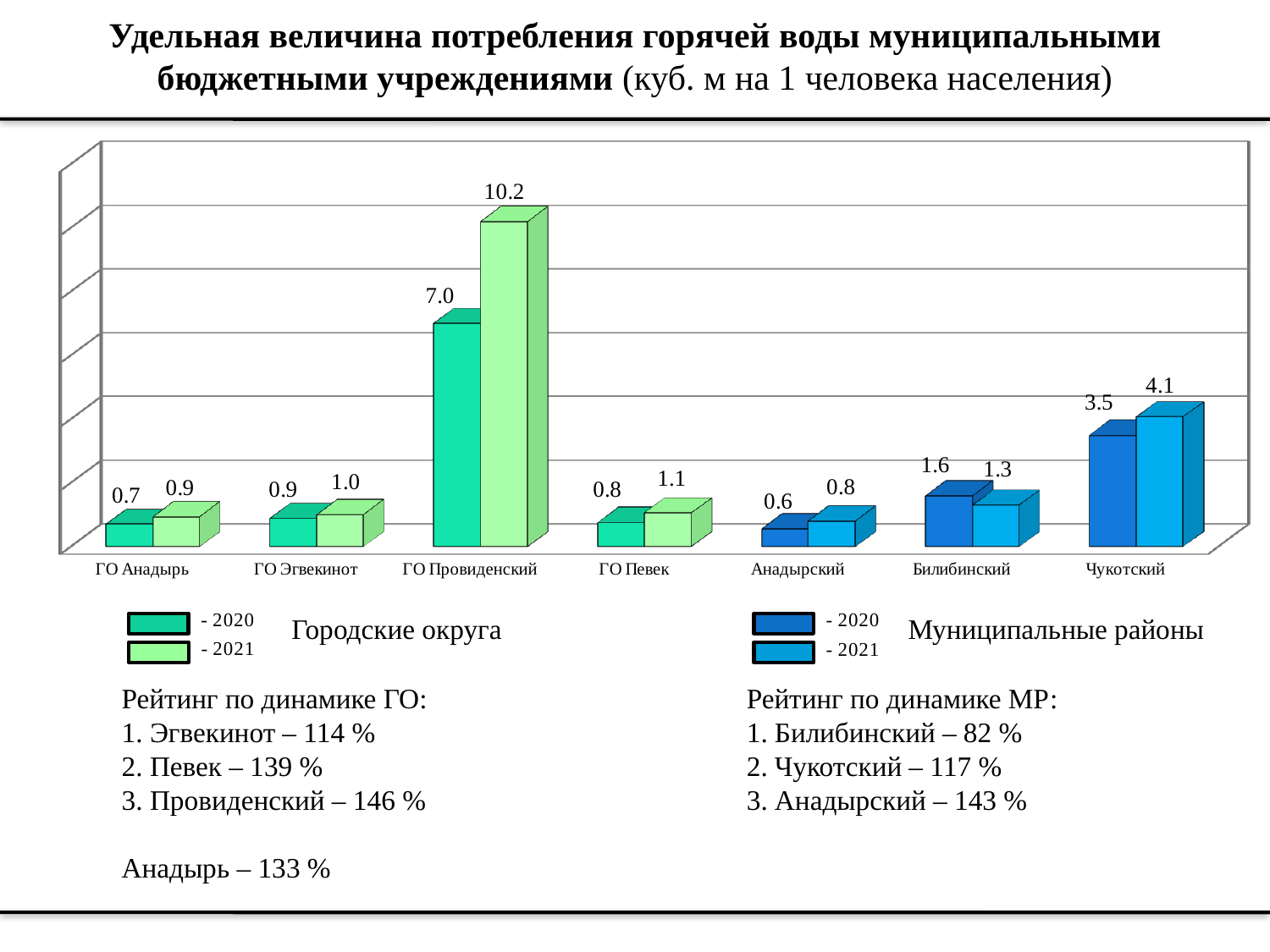
What is the difference between the 2021 and 2020 values for ГО Провиденский? 3.2 What is the 2021 value for ГО Певек? 1.1 Which category has the highest 2021 value? ГО Провиденский Which two years does the legend list for the chart? 2020 and 2021 What is the 2020 value for Анадырский? 0.6 What is the 2020 value for Чукотский? 3.5 How many categories are shown on the x axis of the chart? 7 Which category has the lowest 2020 value? Анадырский What kind of chart is shown on the slide? Bar chart What is the 2021 value for ГО Провиденский? 10.2 What is the difference between the 2020 and 2021 values for Билибинский? 0.3 Which is larger for Билибинский: the 2020 value or the 2021 value? 2020